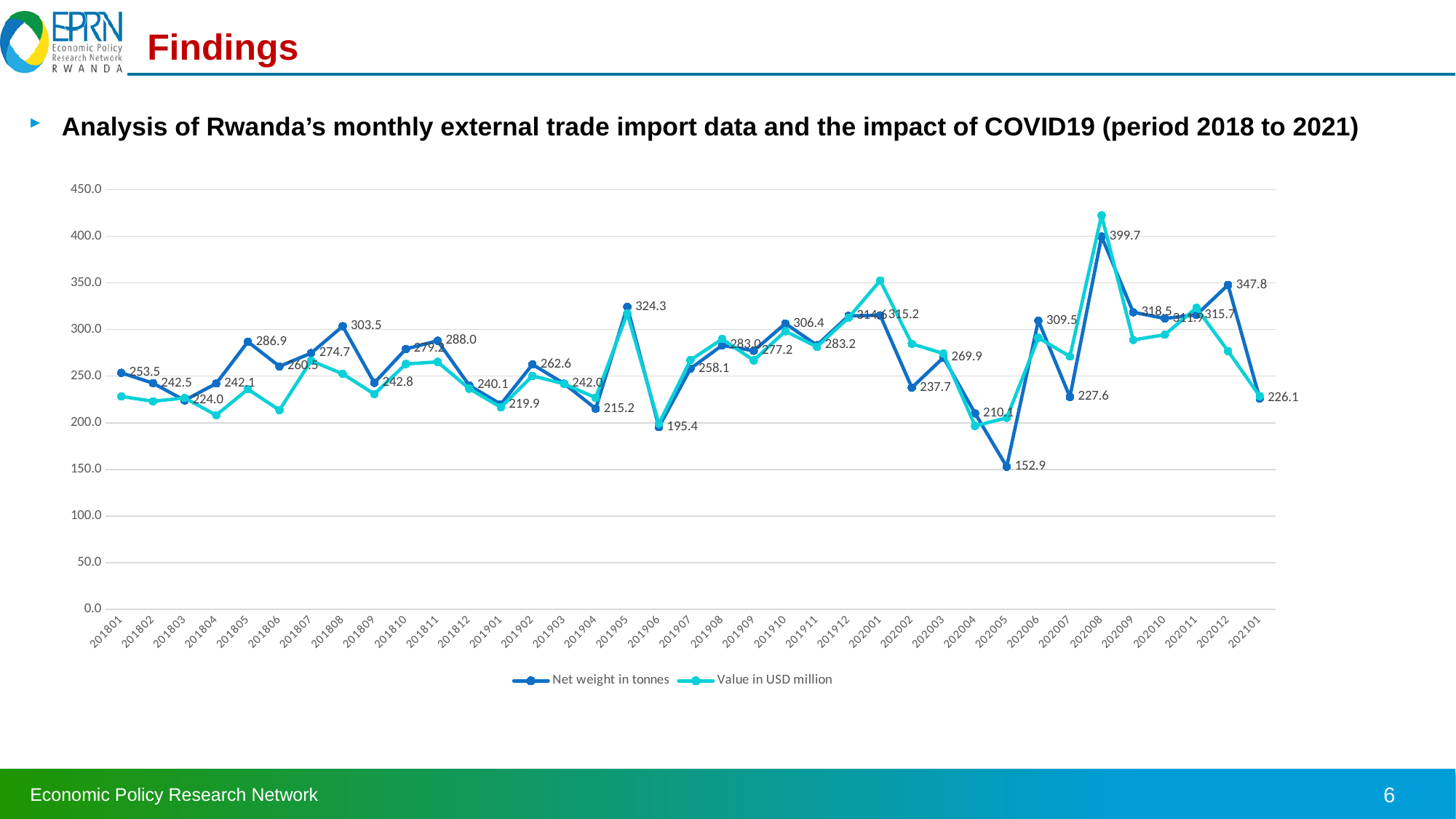
Is the Value in USD million for 201804 greater or less than 250? less What is the Net weight in tonnes for 201905? 324.3 What is the difference in Net weight in tonnes between 202008 and 202005? 246.8 Is the Value in USD million for 202008 greater or less than 400? greater What is the Net weight in tonnes for 202101? 226.1 What is the Net weight in tonnes for 202008? 399.7 How many series does the legend list? 2 What type of chart is shown on the slide? line chart In which month is the Net weight in tonnes lowest? 202005 In which month is the Net weight in tonnes highest? 202008 Which month has a larger Net weight in tonnes, 201808 or 201906? 201808 What are the two series named in the legend? Net weight in tonnes; Value in USD million